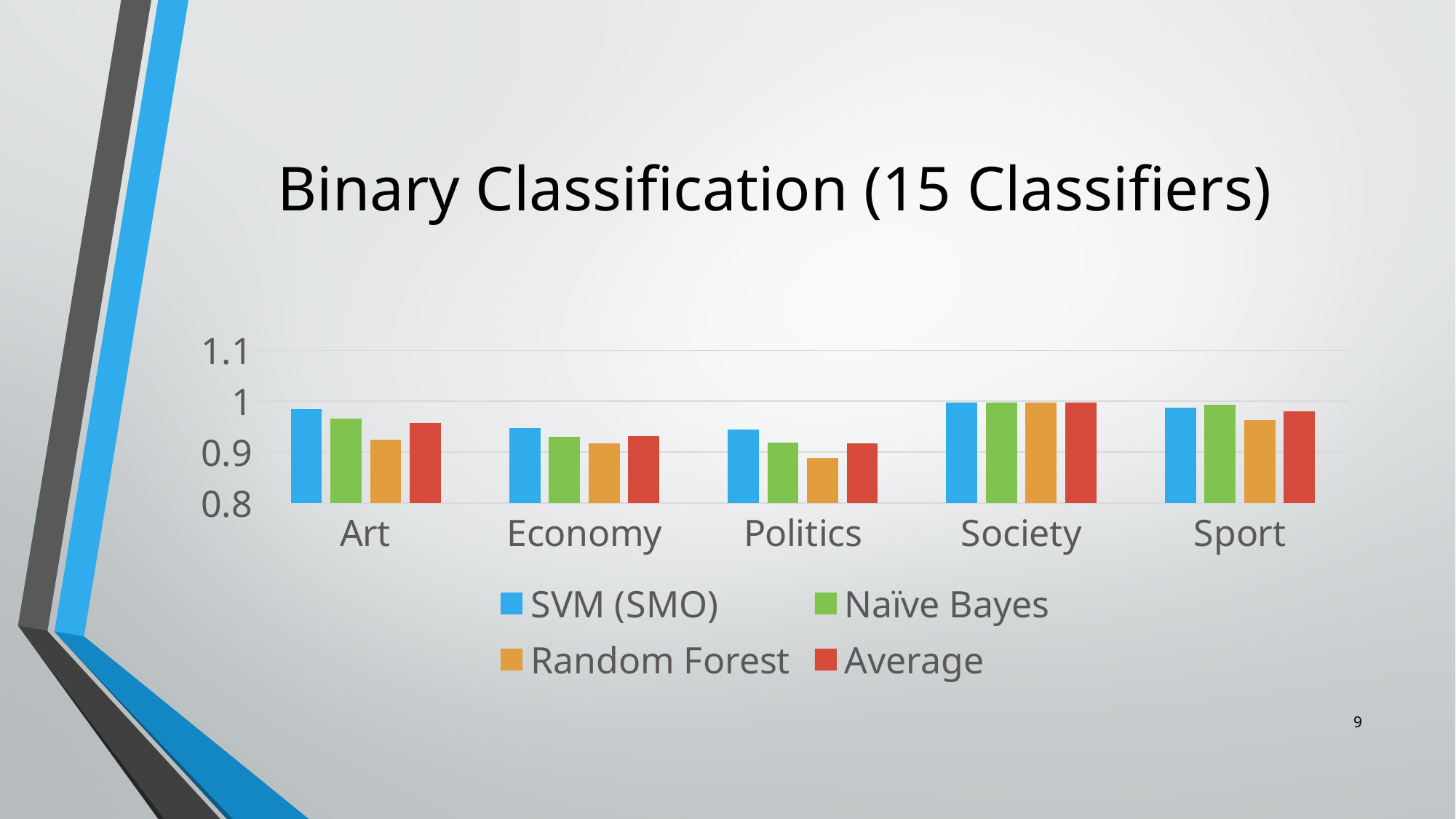
Which colour represents the Random Forest series in the chart? orange Is the Random Forest value for Politics greater or less than 0.9? less Which category has the lowest Random Forest value? Politics What is the title of the slide containing the chart? Binary Classification (15 Classifiers) For Art, which is larger: the SVM (SMO) value or the Random Forest value? SVM (SMO) How many categories are shown on the x axis of the chart? 5 What kind of chart is shown on the slide? bar chart How many series does the chart's legend list? 4 Which category has the highest Random Forest value? Society Is the Naïve Bayes value for Sport greater or less than 0.9? greater Is the SVM (SMO) value for Art greater or less than 0.9? greater For Politics, which is larger: the SVM (SMO) value or the Random Forest value? SVM (SMO)